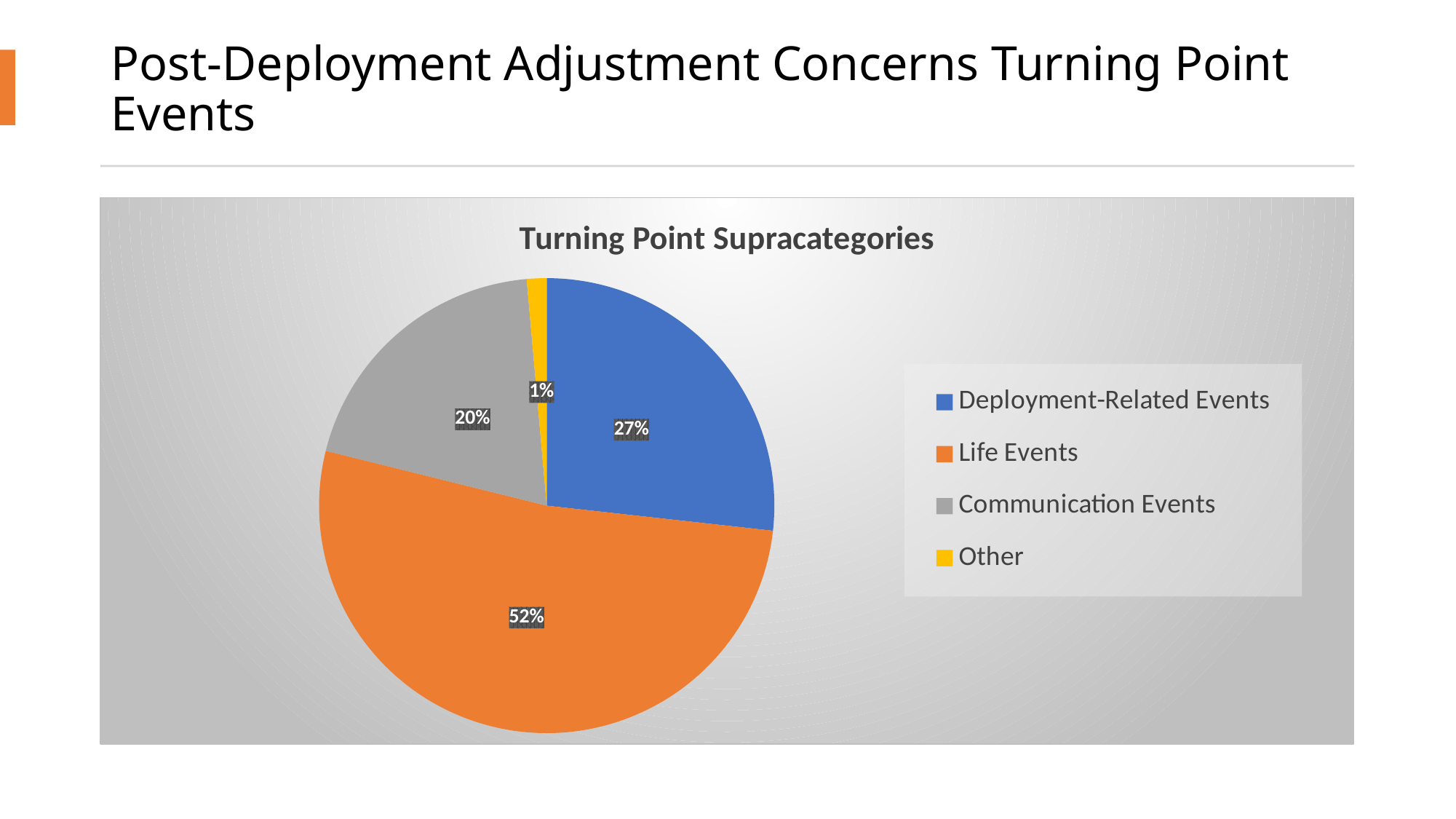
How many categories does the pie chart show? 4 What share of the pie is Communication Events? 20% What colour is the Communication Events slice? grey What type of chart is shown on the slide? pie chart What is the difference in percentage points between Life Events and Deployment-Related Events? 25 Which category has the smallest slice of the pie? Other Which category has the largest slice of the pie? Life Events Which is larger, Deployment-Related Events or Communication Events? Deployment-Related Events What share of the pie is Life Events? 52% What share of the pie is Other? 1% What is the title of the chart? Turning Point Supracategories